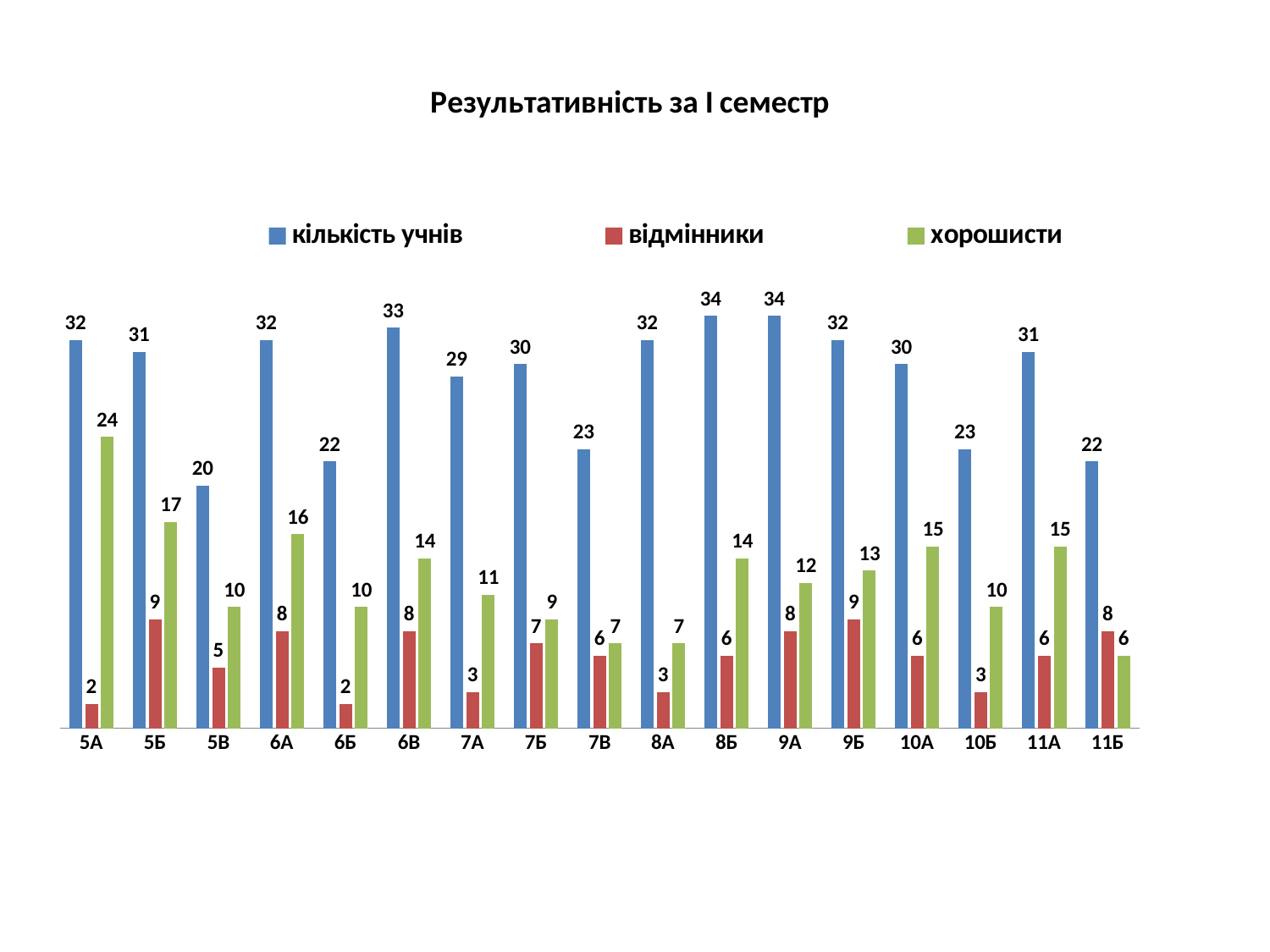
What type of chart is shown on the slide? Bar chart How many series does the legend list? 3 What is the value of кількість учнів for 5В? 20 What is the value of хорошисти for 10А? 15 How many classes are shown on the x axis? 17 What is the value of хорошисти for 5А? 24 Which class has the lowest value for кількість учнів? 5В Which class has the lowest value for хорошисти? 11Б What is the difference between кількість учнів and хорошисти for 6А? 16 What is the value of відмінники for 9Б? 9 Which is larger: відмінники for 5Б or відмінники for 5В? відмінники for 5Б Which class has the highest value for хорошисти? 5А